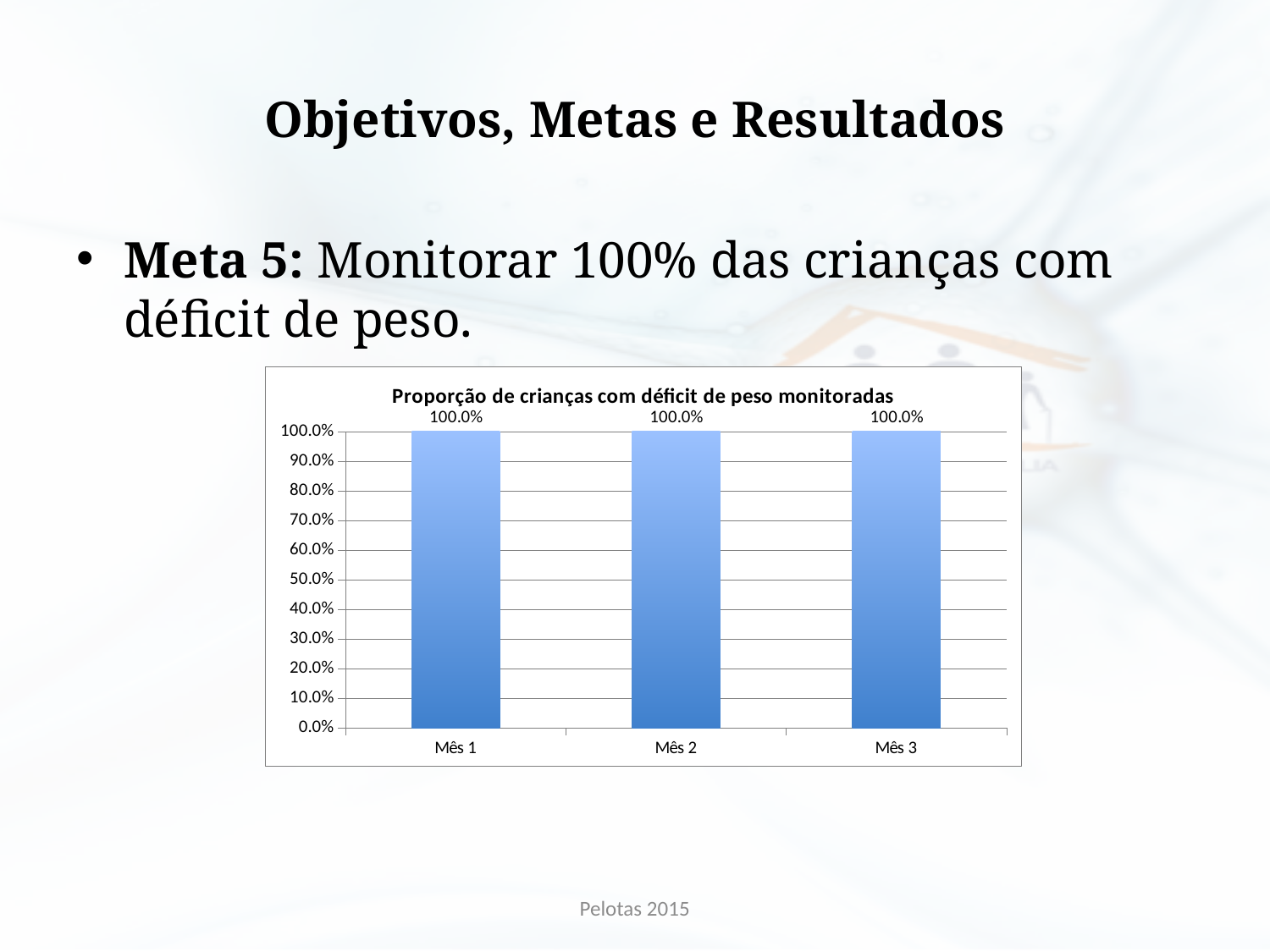
What is the value for Mês 2? 100.0% What is the value for Mês 1? 100.0% What is the value for Mês 3? 100.0% What is the highest value shown on the y axis of the chart? 100.0% What kind of chart is shown on the slide? Bar chart What is the title of the chart? Proporção de crianças com déficit de peso monitoradas What is the difference between the values for Mês 1 and Mês 3? 0.0% How many categories are shown on the x axis of the chart? 3 Is the value for Mês 2 greater or less than 50.0%? greater Do the values rise, fall or stay the same from Mês 1 to Mês 3? Stay the same